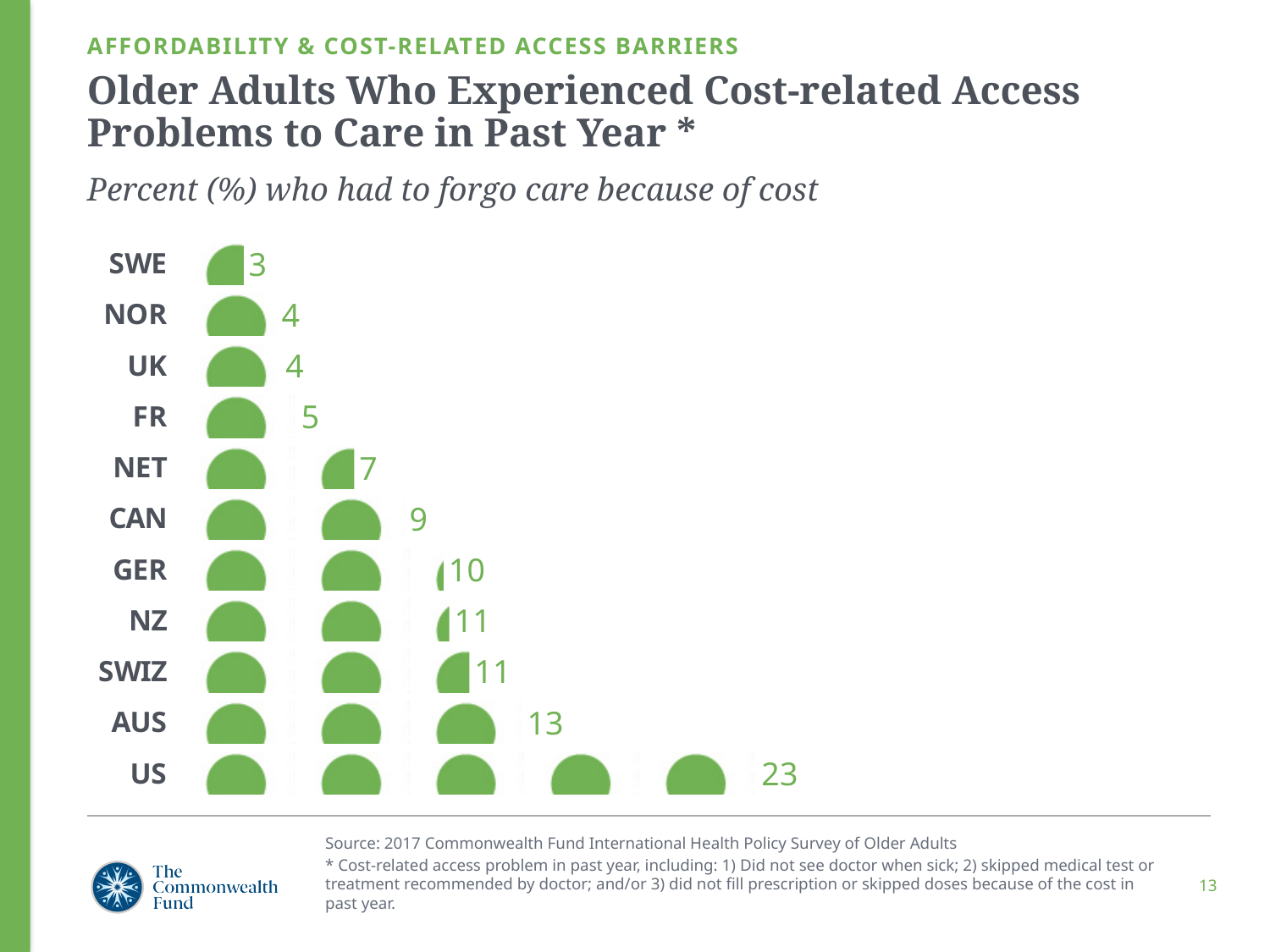
What is the value for the US? 23 What is the value for AUS? 13 What kind of chart is this? bar chart Which country has the lowest value? SWE Do the values rise or fall going from SWE at the top to US at the bottom? rise What is the difference between the values for the US and AUS? 10 Which is larger, the value for NET or the value for NZ? NZ How many countries are shown in the chart? 11 Which country has the highest value? US What is the value for SWE? 3 What is the value for CAN? 9 What is the difference between the values for GER and FR? 5